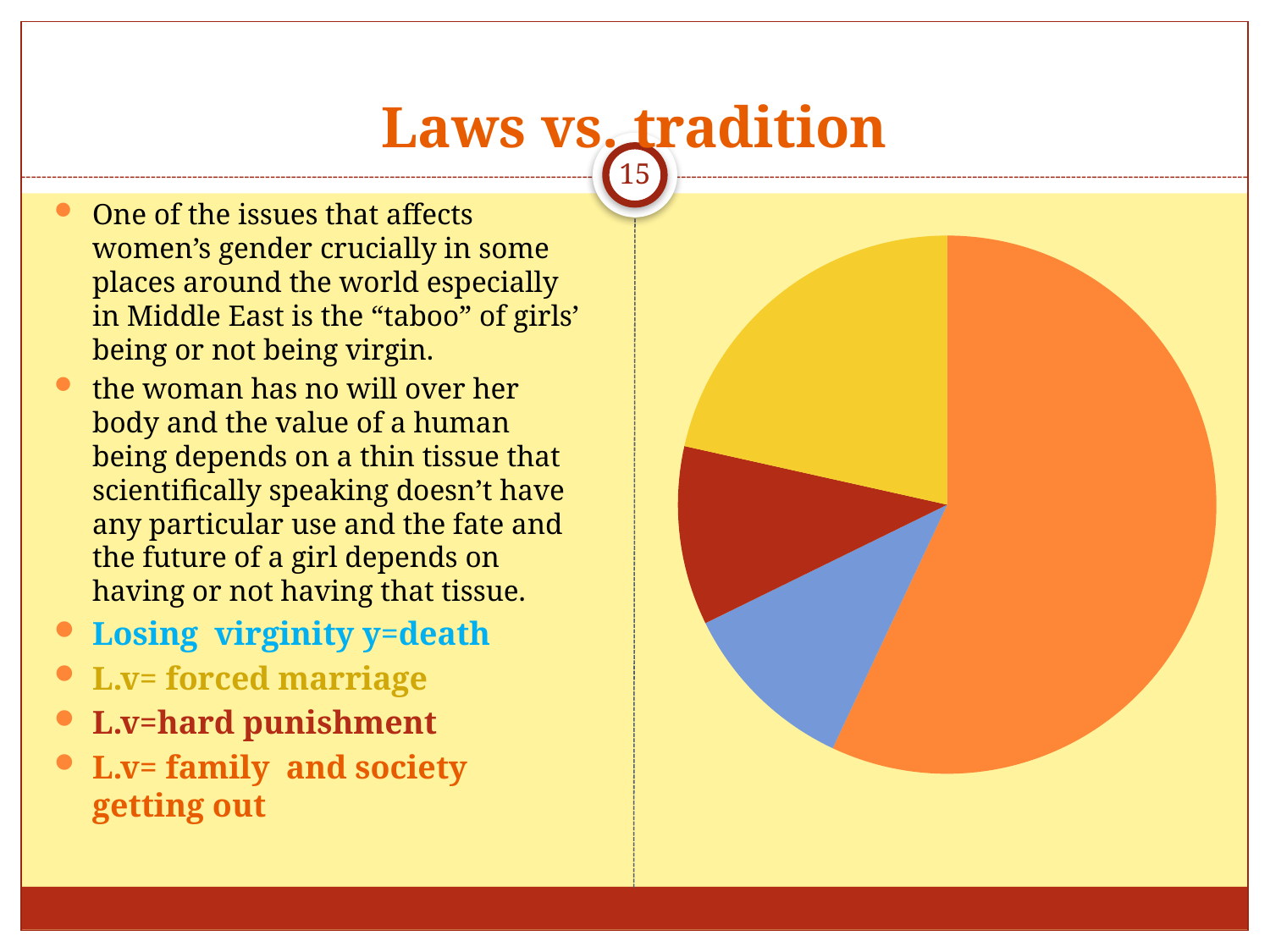
Which slice is larger in the pie chart, the yellow slice or the blue slice? yellow How many slices does the pie chart have? 4 What kind of chart is shown on the slide? pie chart Does the orange slice take up more or less than half of the pie chart? more What is the title of the slide containing the pie chart? Laws vs. tradition Which slice is larger in the pie chart, the orange slice or the yellow slice? orange Which colour slice is the largest in the pie chart? orange Which slice is larger in the pie chart, the orange slice or the dark red slice? orange Does the yellow slice take up more or less than half of the pie chart? less